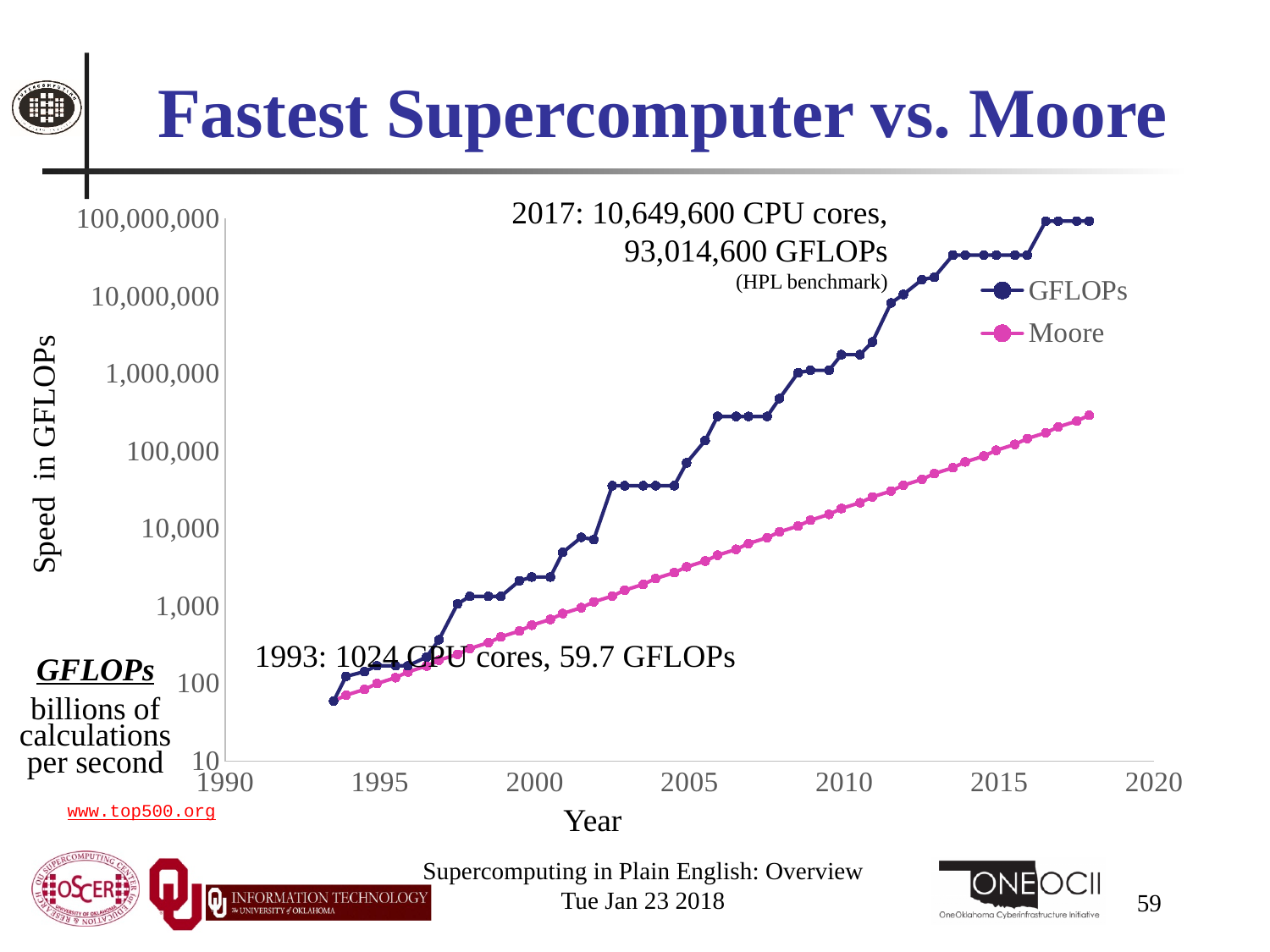
How many series does the legend list? 2 What are the two series named in the legend? GFLOPs and Moore Is the GFLOPs value in 2005 greater or less than 10,000? greater By how many GFLOPs did the annotated 2017 speed exceed the annotated 1993 speed? 93,014,540.3 GFLOPs What is the label on the x axis? Year In 2015, which series has the higher value, GFLOPs or Moore? GFLOPs How many CPU cores did the fastest supercomputer have in 2017, according to the annotation? 10,649,600 Is the Moore value in 2015 greater or less than 1,000,000? less According to the annotation, what was the speed of the fastest supercomputer in 1993? 59.7 GFLOPs Does the GFLOPs series rise or fall as the year increases? rise What kind of chart is shown on the slide? line chart According to the annotation, what was the speed of the fastest supercomputer in 2017? 93,014,600 GFLOPs